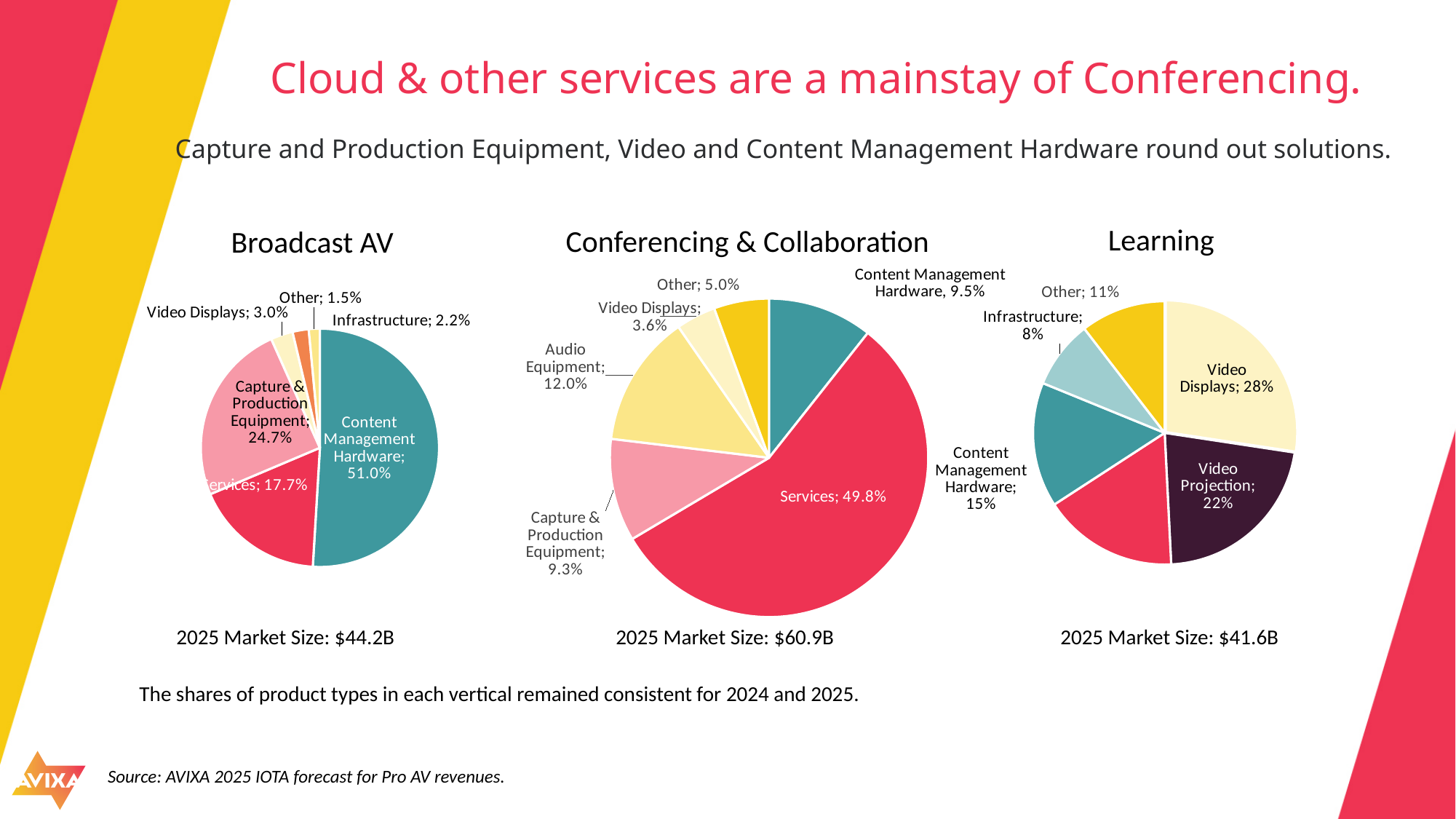
How many slices does the Broadcast AV pie chart have? 6 In the Conferencing & Collaboration pie chart, which is larger: Content Management Hardware or Capture & Production Equipment? Content Management Hardware In the Conferencing & Collaboration pie chart, what share does Audio Equipment hold? 12.0% In the Conferencing & Collaboration pie chart, which category has the smallest share? Video Displays In the Broadcast AV pie chart, which category has the smallest share? Other In the Learning pie chart, what share does Video Projection hold? 22% In the Conferencing & Collaboration pie chart, what share does Services hold? 49.8% In the Broadcast AV pie chart, what share does Content Management Hardware hold? 51.0% In the Broadcast AV pie chart, what is the difference between the shares of Capture & Production Equipment and Services? 7.0% What type of chart is used for Conferencing & Collaboration? Pie chart In the Learning pie chart, what is the difference between the shares of Video Displays and Video Projection? 6% In the Broadcast AV pie chart, which category has the largest share? Content Management Hardware